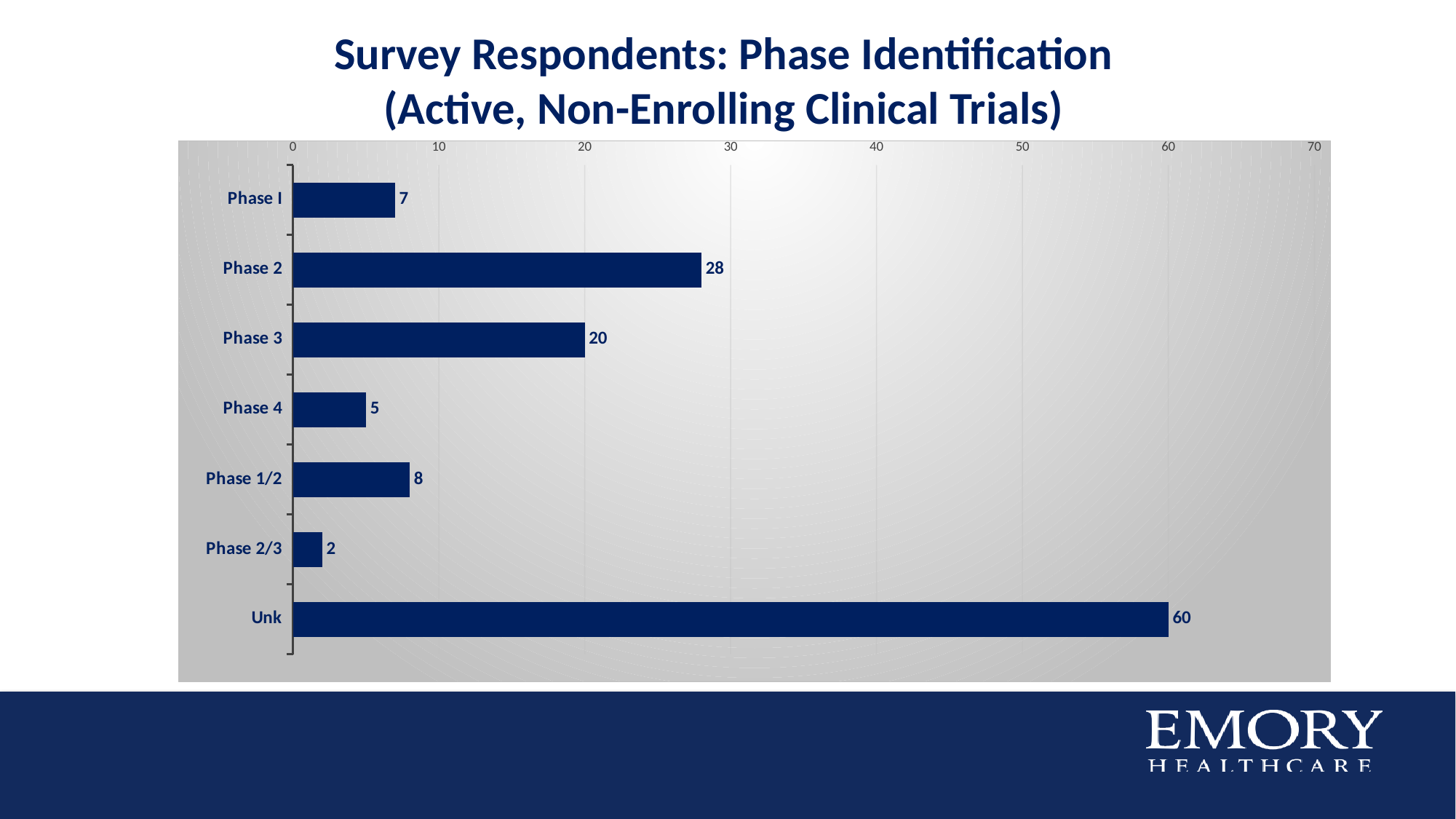
What is the title of the chart? Survey Respondents: Phase Identification (Active, Non-Enrolling Clinical Trials) What is the value for Phase 4? 5 Which category has the highest value? Unk What is the value for Unk? 60 How many categories are shown in the chart? 7 What is the value for Phase 1/2? 8 What kind of chart is shown on the slide? Bar chart Is the value for Phase 3 greater or less than 10? greater Which category has the lowest value? Phase 2/3 Which is larger, the value for Phase I or the value for Phase 1/2? Phase 1/2 What is the value for Phase 2? 28 What is the difference between the values for Phase 2 and Phase 3? 8